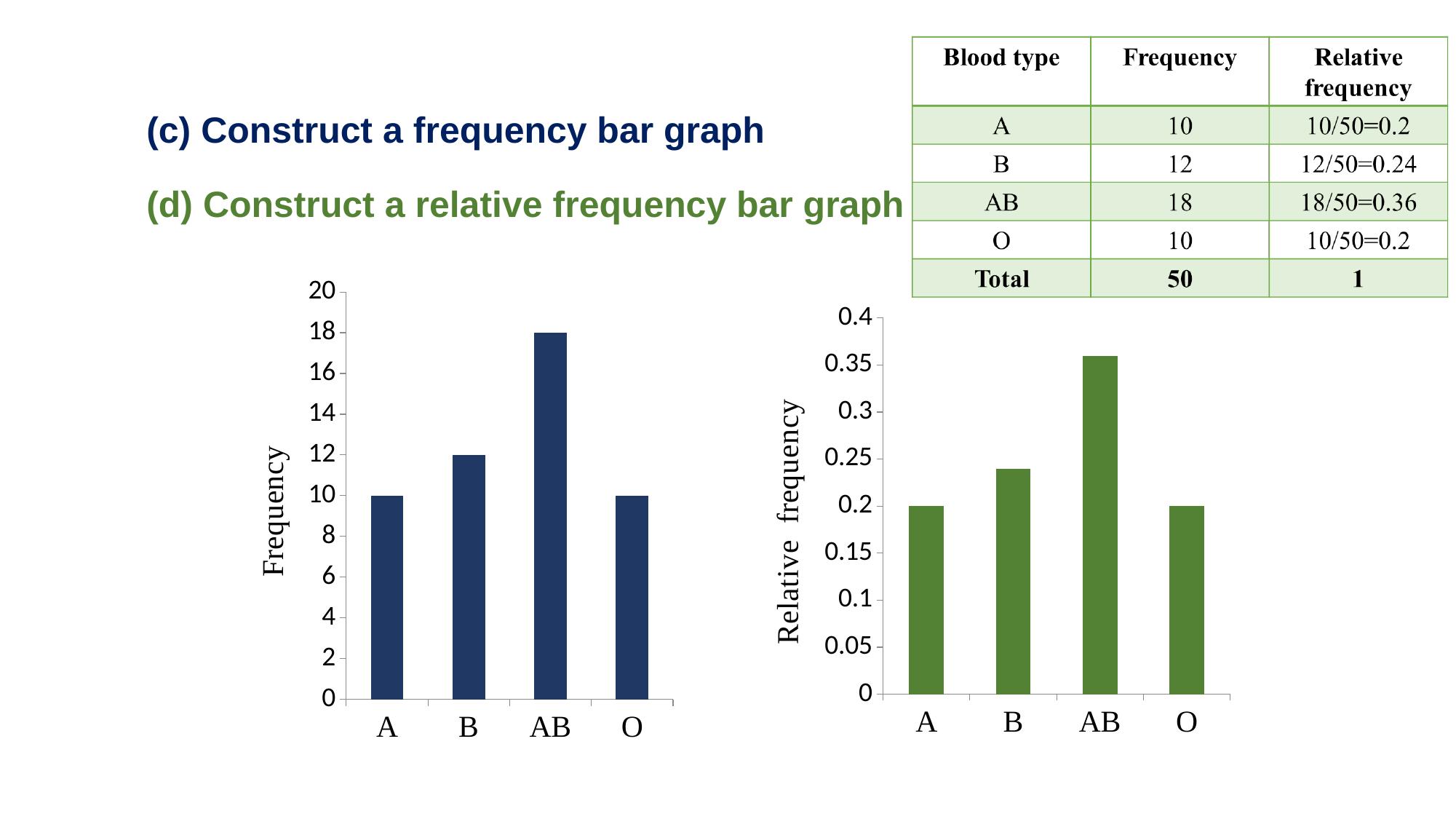
In the right chart (Relative frequency), what is the relative frequency for blood type A? 0.2 What kind of chart is the left chart (Frequency)? Bar chart In the left chart (Frequency), what is the frequency for blood type B? 12 In the left chart (Frequency), is the frequency for B larger than the frequency for A? Yes In the right chart (Relative frequency), is the value for AB greater or less than 0.35? greater In the right chart (Relative frequency), is the value for B greater or less than 0.25? less In the left chart (Frequency), how many blood type categories are shown on the x axis? 4 In the right chart (Relative frequency), which blood type has the highest relative frequency? AB In the left chart (Frequency), what is the frequency for blood type AB? 18 In the left chart (Frequency), what is the difference between the frequencies of AB and B? 6 What colour are the bars in the right chart (Relative frequency)? Green In the left chart (Frequency), which blood type has the highest frequency? AB